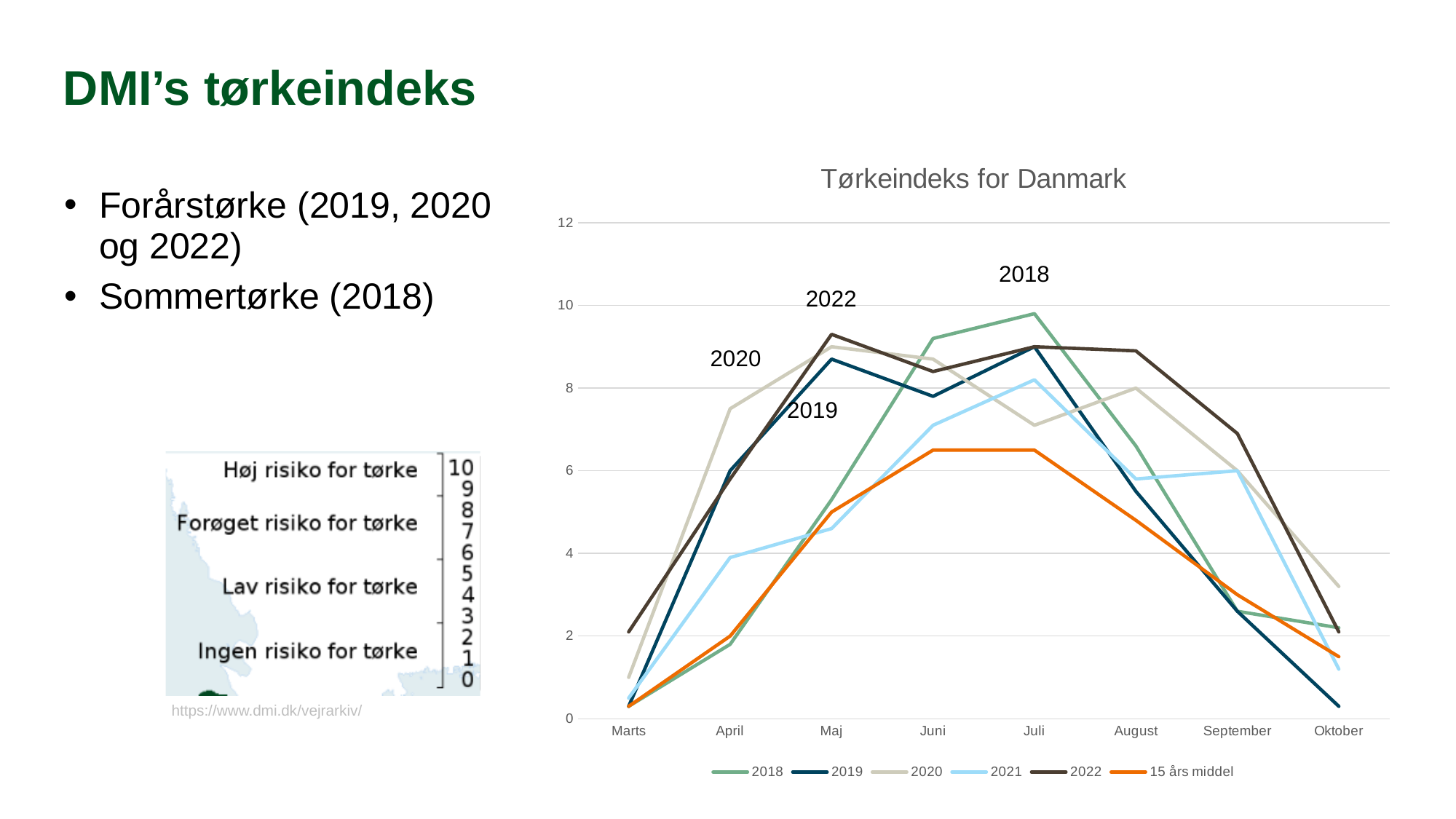
Is the value for 15 års middel in Juli greater or less than 8? less How many series does the chart legend list? 6 Which legend entry represents the 15-year average? 15 års middel What kind of chart is shown on the slide? line chart Which series has the highest value in Juli? 2018 How many months are shown along the x axis of the chart? 8 What is the title of the chart? Tørkeindeks for Danmark Is the value for 2019 in Oktober greater or less than 2? less Which series has the highest value in April? 2020 In Maj, which is higher: 2022 or 2021? 2022 Is the value for 2021 in September greater or less than 4? greater